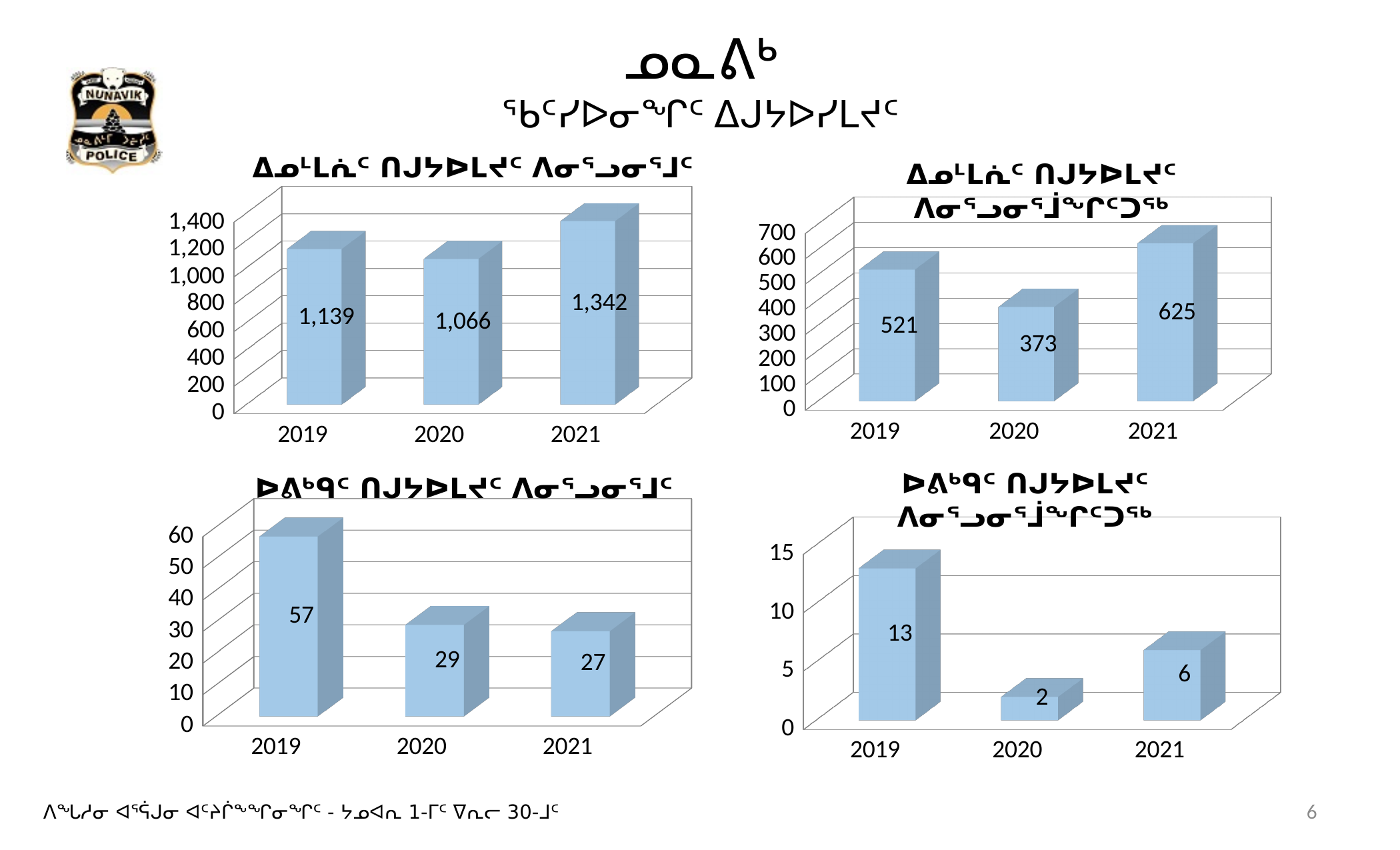
In the bottom-left chart, do the values rise or fall from 2019 to 2021? fall In the top-left chart, what is the value for 2021? 1,342 In the top-right chart, what is the value for 2020? 373 In the top-right chart, is the value for 2019 larger or smaller than the value for 2021? smaller In the top-right chart, which year has the highest value? 2021 In the top-left chart, which year has the lowest value? 2020 In the top-left chart, what is the difference between the 2021 and 2019 values? 203 In the bottom-right chart, what is the value for 2020? 2 In the bottom-left chart, what is the value for 2019? 57 In the bottom-right chart, which year has the highest value? 2019 How many years are shown on the x axis of the bottom-right chart? 3 In the bottom-left chart, what is the difference between the 2019 and 2020 values? 28